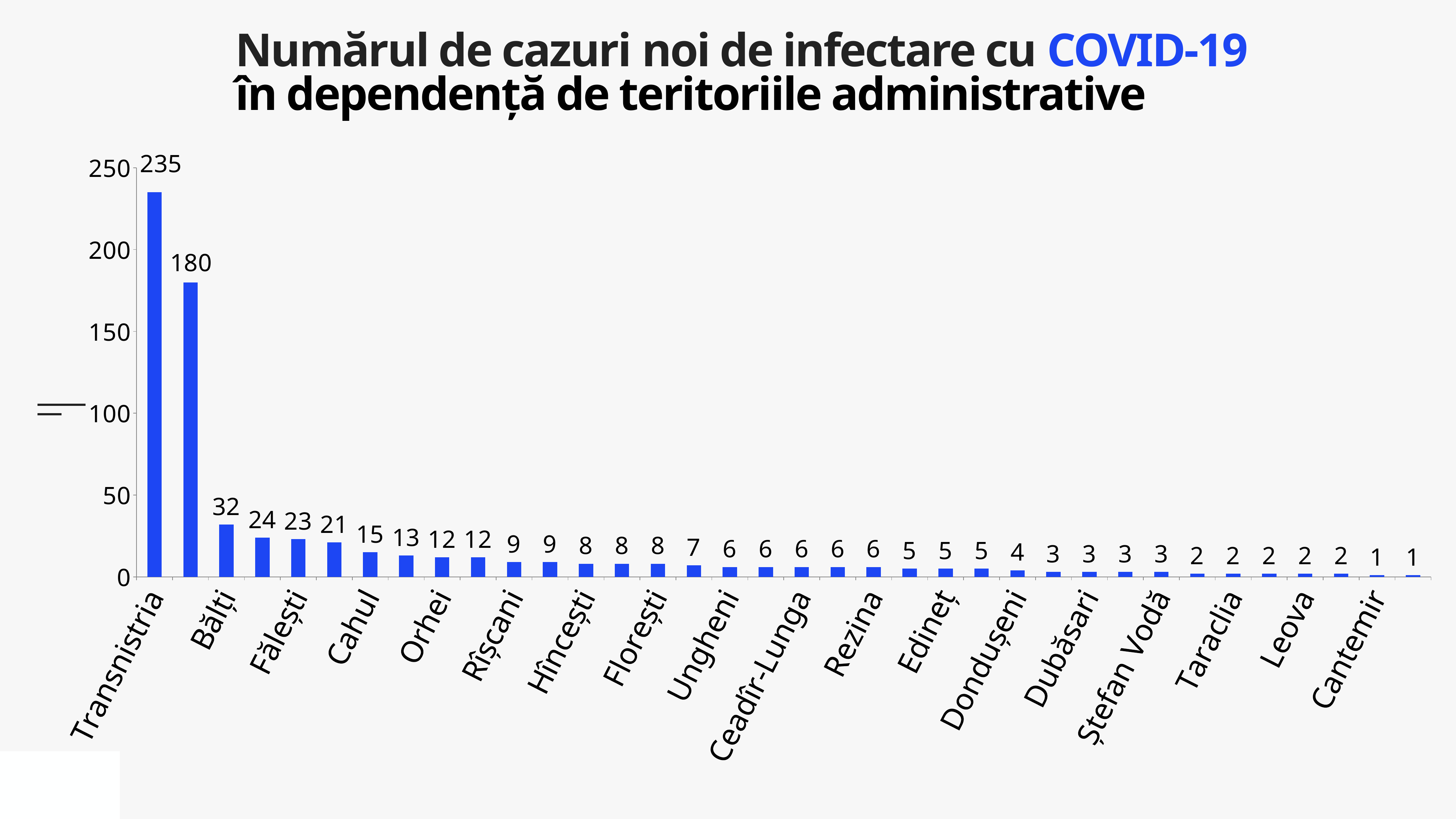
Which territory has the highest number of new COVID-19 cases? Transnistria What is the difference between the highest bar (235) and the second-highest bar (180)? 55 What colour are the bars in the chart? blue Which is larger, the value for Transnistria or the value of the bar immediately to its right? Transnistria What is the smallest value labelled on any bar in the chart? 1 What is the highest tick value shown on the vertical axis? 250 How many bars are plotted in the chart? 36 What is the value of the second-highest bar in the chart? 180 Is the value for Transnistria greater or less than 200? greater Do the bar values rise or fall from left to right along the x axis? fall How many new COVID-19 cases are shown for Transnistria? 235 What kind of chart is shown on the slide? bar chart